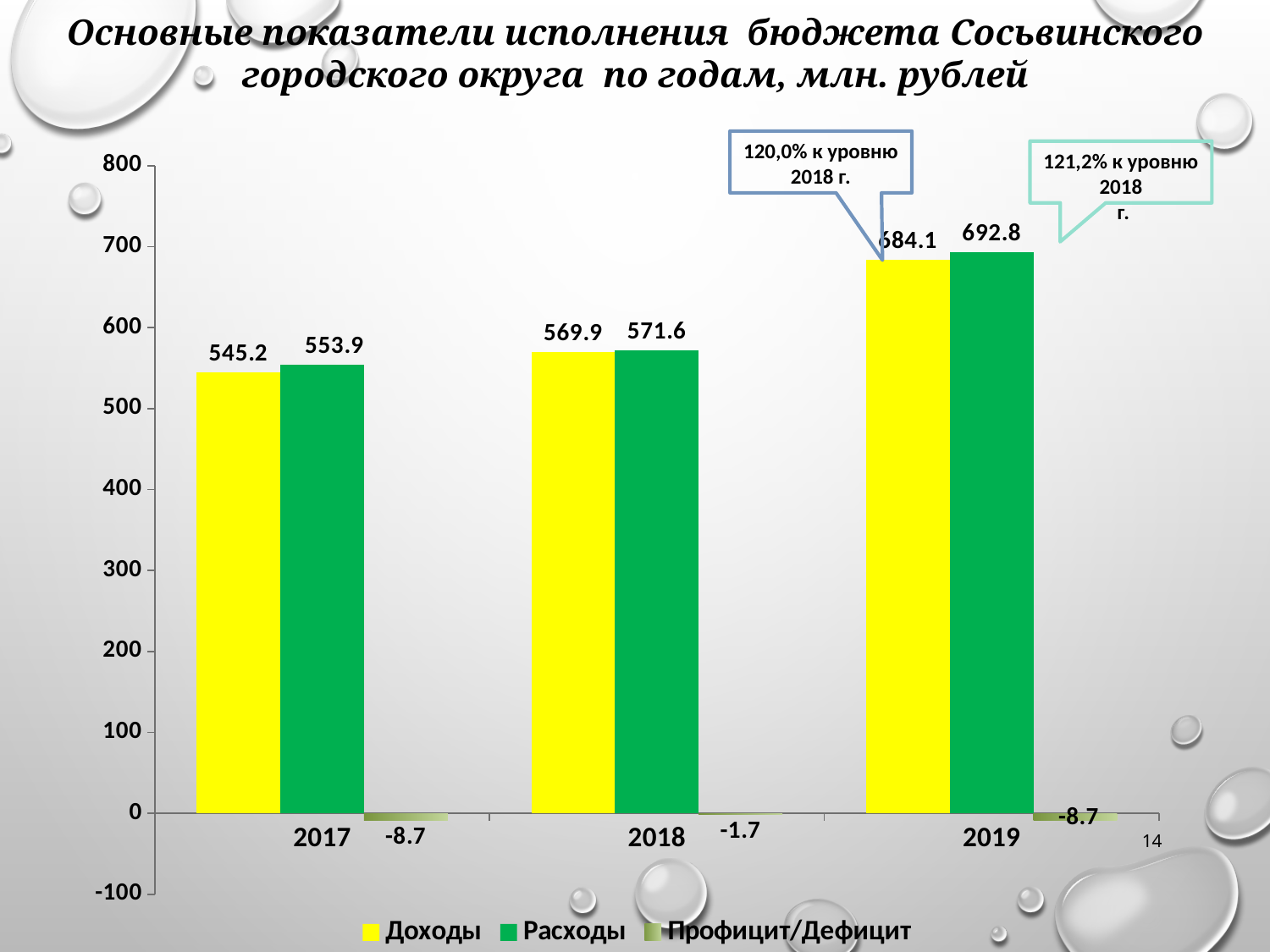
In 2018, which is larger: Доходы or Расходы? Расходы Is the value of Доходы for 2019 greater or less than 600? greater In which year is Расходы the highest? 2019 What is the value of Профицит/Дефицит for 2018? -1.7 How many years are shown on the x axis? 3 What is the value of Доходы for 2017? 545.2 What is the difference between Расходы and Доходы in 2017? 8.7 In which year is Доходы the lowest? 2017 Do the Расходы values rise or fall from 2017 to 2019? rise What is the value of Расходы for 2019? 692.8 How many series does the legend list? 3 What is the value of Расходы for 2018? 571.6